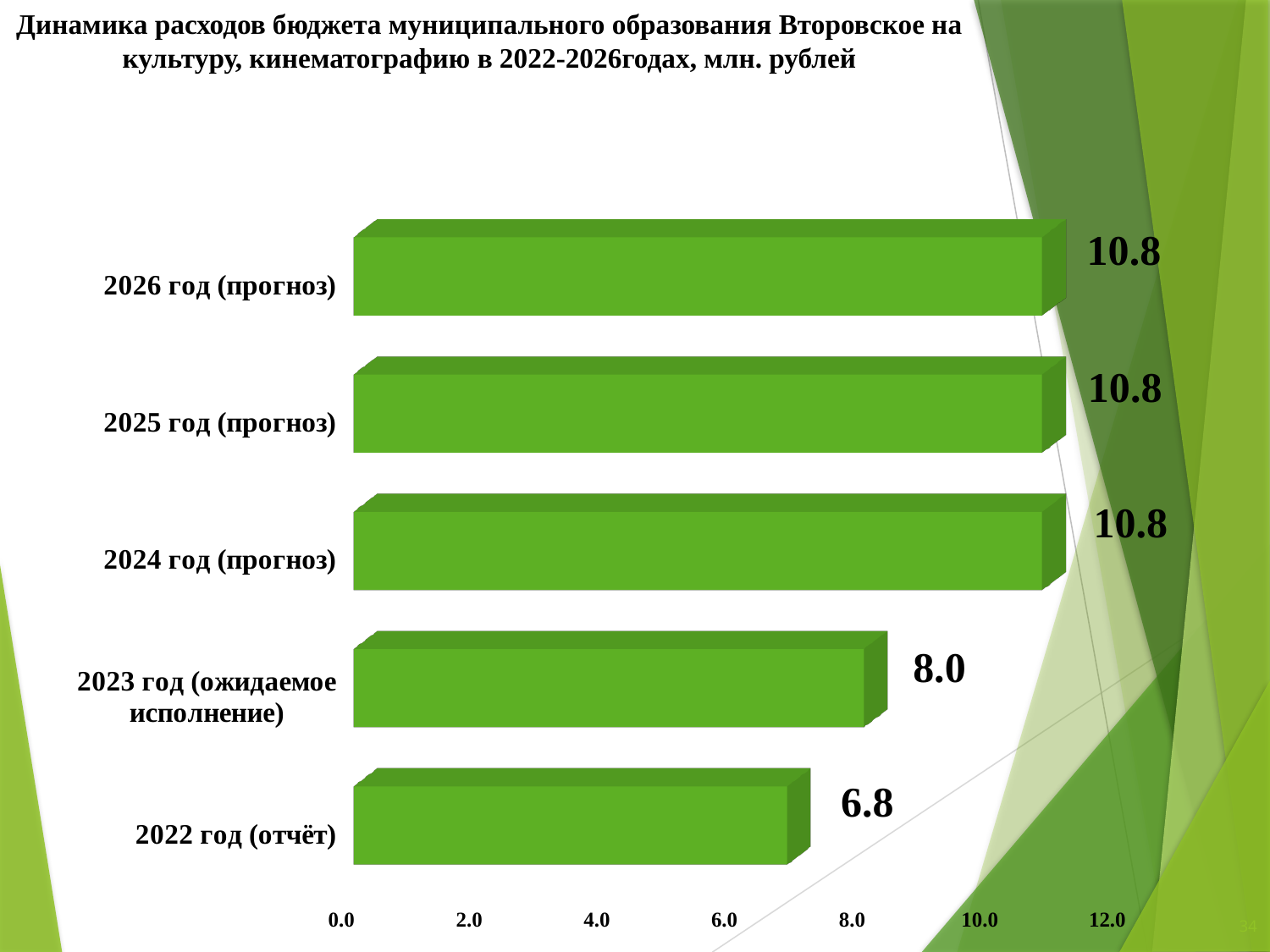
What is the value for 2026 год (прогноз)? 10.8 What is the value for 2024 год (прогноз)? 10.8 What unit of measurement is stated in the chart title? млн. рублей Is the value for 2022 год (отчёт) greater or less than 8.0? less What kind of chart is shown on the slide? bar chart What is the difference between the values for 2024 год (прогноз) and 2023 год (ожидаемое исполнение)? 2.8 What is the value for 2023 год (ожидаемое исполнение)? 8.0 Which category has the lowest value? 2022 год (отчёт) Which is larger, the value for 2025 год (прогноз) or the value for 2023 год (ожидаемое исполнение)? 2025 год (прогноз) What is the difference between the values for 2023 год (ожидаемое исполнение) and 2022 год (отчёт)? 1.2 What is the value for 2022 год (отчёт)? 6.8 How many categories are shown in the chart? 5